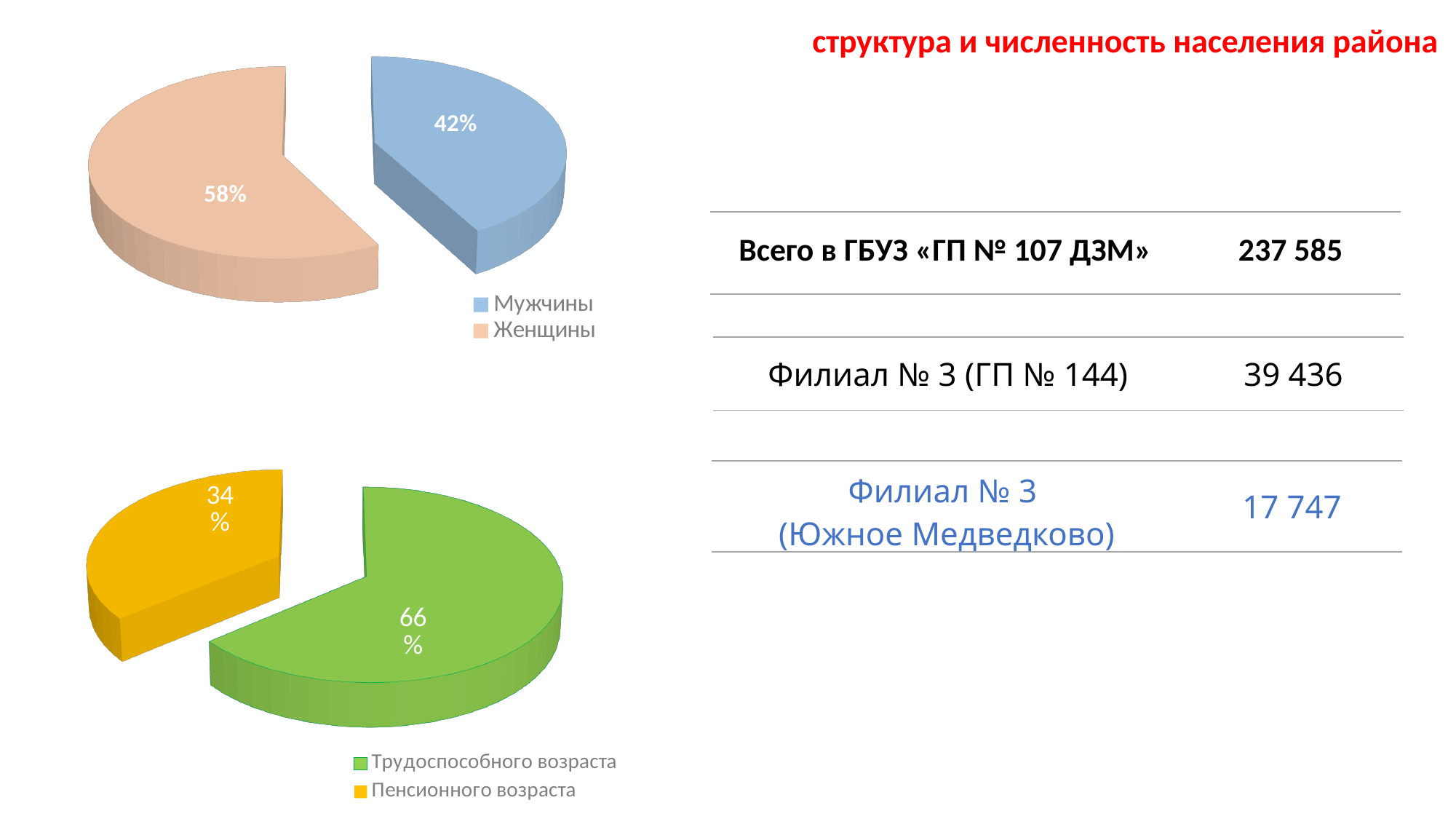
In the bottom pie chart, what is the difference in percentage points between Трудоспособного возраста and Пенсионного возраста? 32 In the bottom pie chart, what share is labelled for Пенсионного возраста? 34% In the top pie chart, what share is labelled for Женщины? 58% In the bottom pie chart, what colour is the slice for Пенсионного возраста? yellow In the top pie chart, what colour is the slice for Мужчины? blue In the bottom pie chart, which category has the smaller slice? Пенсионного возраста In the top pie chart, which category has the larger slice? Женщины In the top pie chart, what share is labelled for Мужчины? 42% How many slices does the top pie chart have? 2 In the top pie chart, what is the difference in percentage points between Женщины and Мужчины? 16 What type of chart is the top chart on the slide? pie chart In the bottom pie chart, what share is labelled for Трудоспособного возраста? 66%